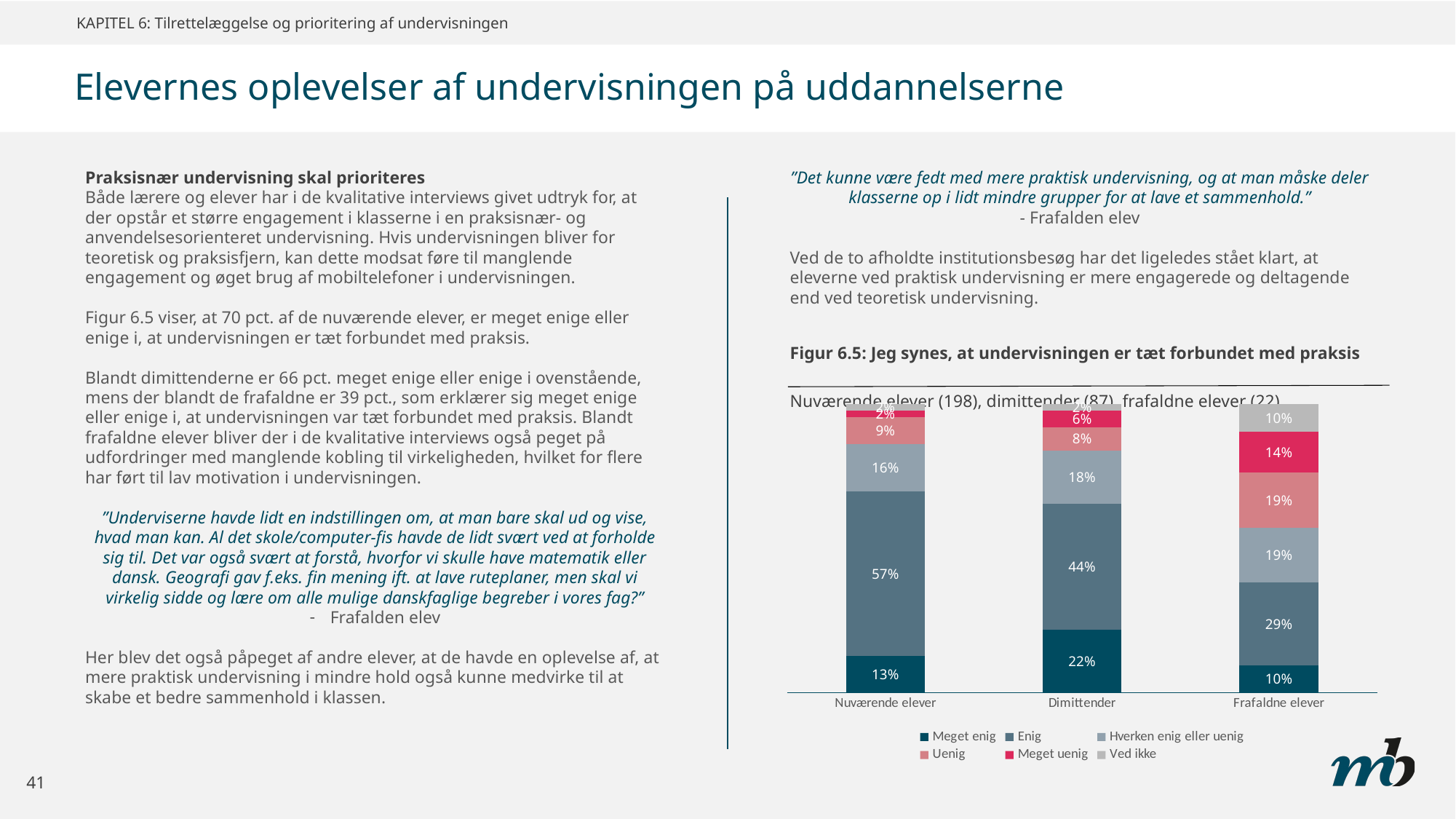
Which is larger: the 'Uenig' value for Frafaldne elever or the 'Uenig' value for Nuværende elever? Frafaldne elever What is the 'Meget uenig' value for Frafaldne elever? 14% What is the difference between the 'Enig' values for Nuværende elever and Dimittender? 13 percentage points What is the 'Meget enig' value for Dimittender? 22% How many series does the chart's legend list? 6 What is the 'Enig' value for Nuværende elever? 57% Which category has the lowest 'Meget enig' value? Frafaldne elever Which category has the highest 'Enig' value? Nuværende elever What is the title of the figure shown on the slide? Figur 6.5: Jeg synes, at undervisningen er tæt forbundet med praksis How many categories (groups of respondents) are shown on the x axis of the chart? 3 What kind of chart is shown in Figur 6.5? Stacked bar chart What is the 'Hverken enig eller uenig' value for Dimittender? 18%